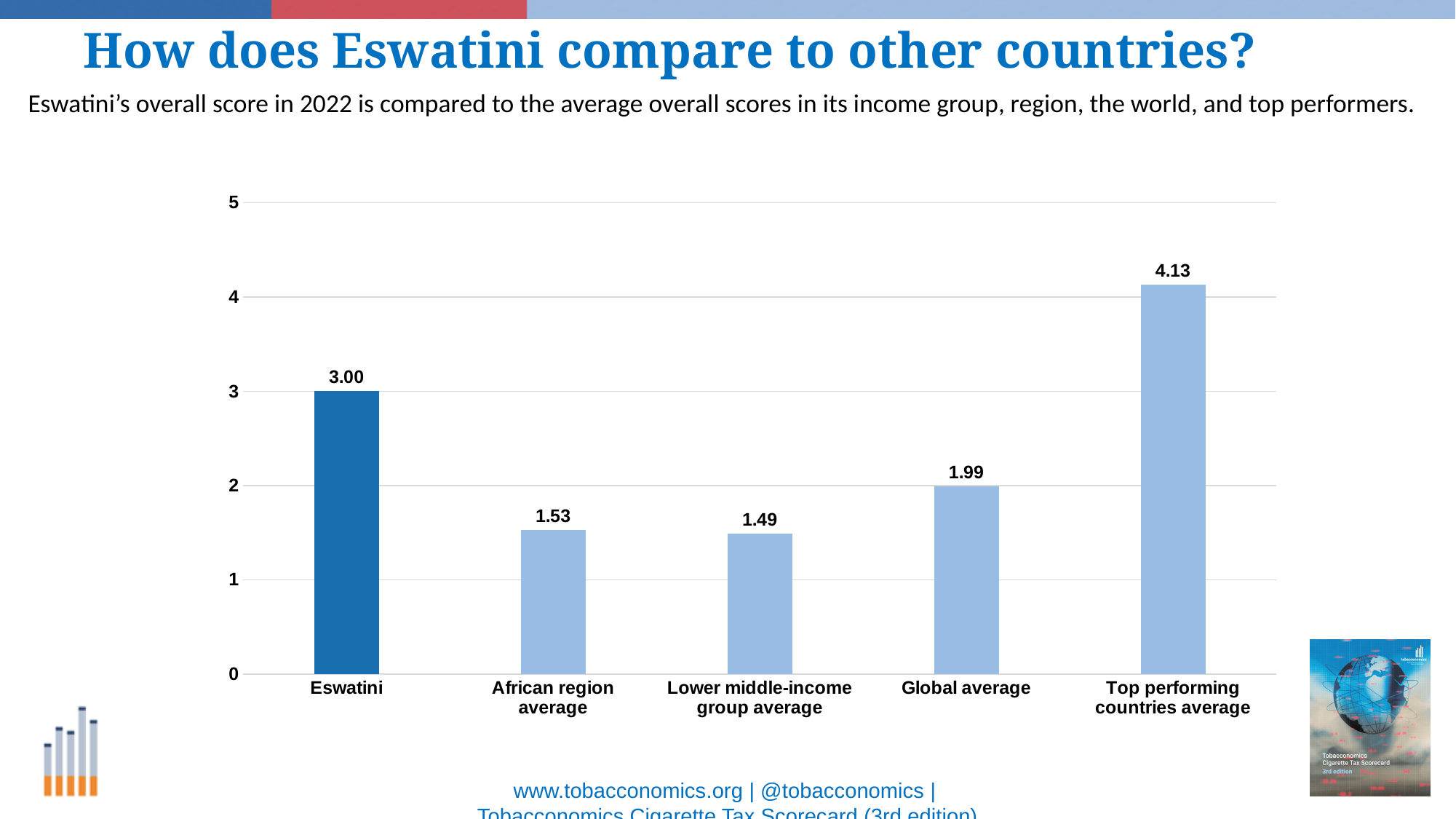
What is the value for the African region average? 1.53 Which is larger, Eswatini or the Global average? Eswatini What is the value for the Lower middle-income group average? 1.49 What is the value for the Top performing countries average? 4.13 What is the difference between Eswatini and the Global average? 1.01 Which category has the highest value? Top performing countries average Which category has the lowest value? Lower middle-income group average What is the value for the Global average? 1.99 How many categories are shown on the chart? 5 What is the value for Eswatini? 3.00 What kind of chart is shown on the slide? Bar chart What is the difference between the Top performing countries average and Eswatini? 1.13